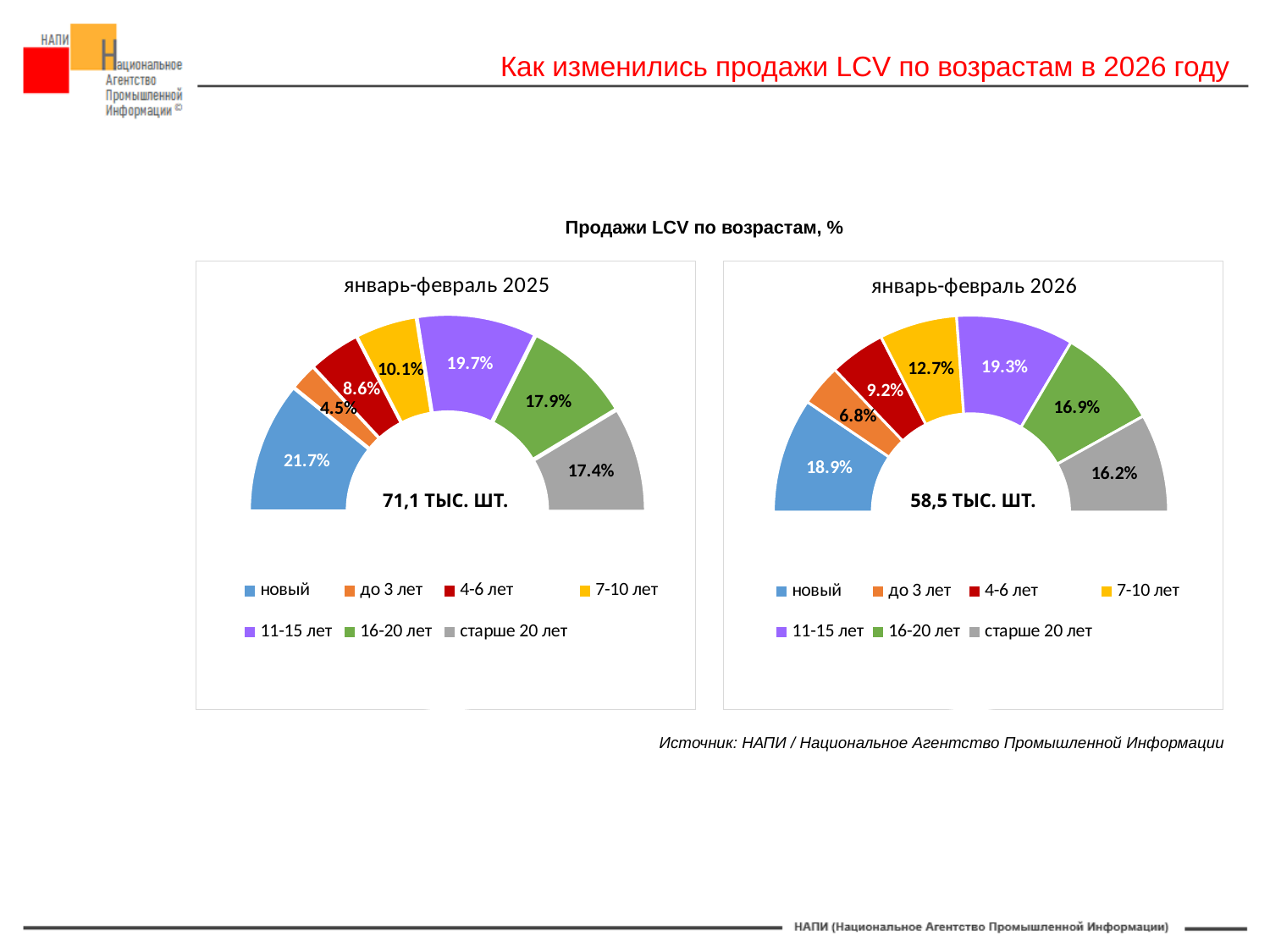
Which is larger: the '16-20 лет' share in the 'январь-февраль 2025' chart or in the 'январь-февраль 2026' chart? январь-февраль 2025 What total volume is printed in the centre of the 'январь-февраль 2025' chart? 71,1 ТЫС. ШТ. What type of chart is used for 'январь-февраль 2026'? Doughnut (half-ring) chart What is the difference in percentage points between the 'новый' share in the 'январь-февраль 2025' chart and in the 'январь-февраль 2026' chart? 2.8 How many categories does the legend of the 'январь-февраль 2026' chart list? 7 In the 'январь-февраль 2026' chart, which category has the smallest share? до 3 лет In the 'январь-февраль 2026' chart, what share is shown for the 'до 3 лет' category? 6.8% In the 'январь-февраль 2025' chart, which category has the largest share? новый In the 'январь-февраль 2025' chart, which category has the smallest share? до 3 лет In the 'январь-февраль 2026' chart, which category has the largest share? 11-15 лет In the 'январь-февраль 2025' chart, what share is shown for the 'новый' category? 21.7% In the 'январь-февраль 2026' chart, what share is shown for the '7-10 лет' category? 12.7%